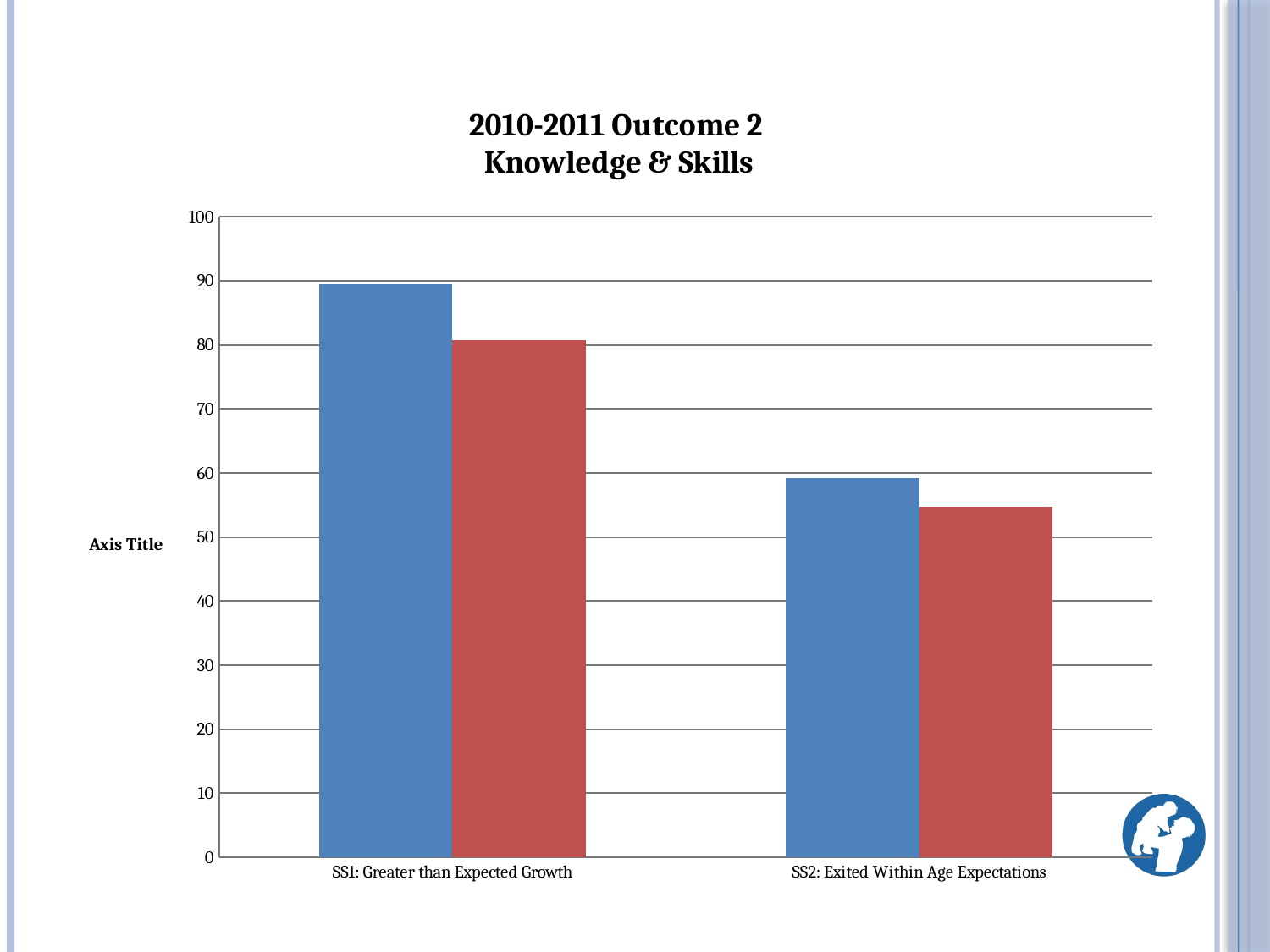
What kind of chart is shown on the slide? bar chart Which category has the lowest red bar? SS2: Exited Within Age Expectations Is the value of the blue bar for SS2: Exited Within Age Expectations greater or less than 50? greater How many categories are shown on the x axis? 2 For SS1: Greater than Expected Growth, which bar is taller, the blue bar or the red bar? the blue bar What is the title of the chart? 2010-2011 Outcome 2 Knowledge & Skills Is the value of the red bar for SS2: Exited Within Age Expectations greater or less than 60? less Is the value of the blue bar for SS1: Greater than Expected Growth greater or less than 80? greater How many bars are plotted in the chart? 4 What is the label shown on the vertical axis? Axis Title Which category has the highest blue bar? SS1: Greater than Expected Growth